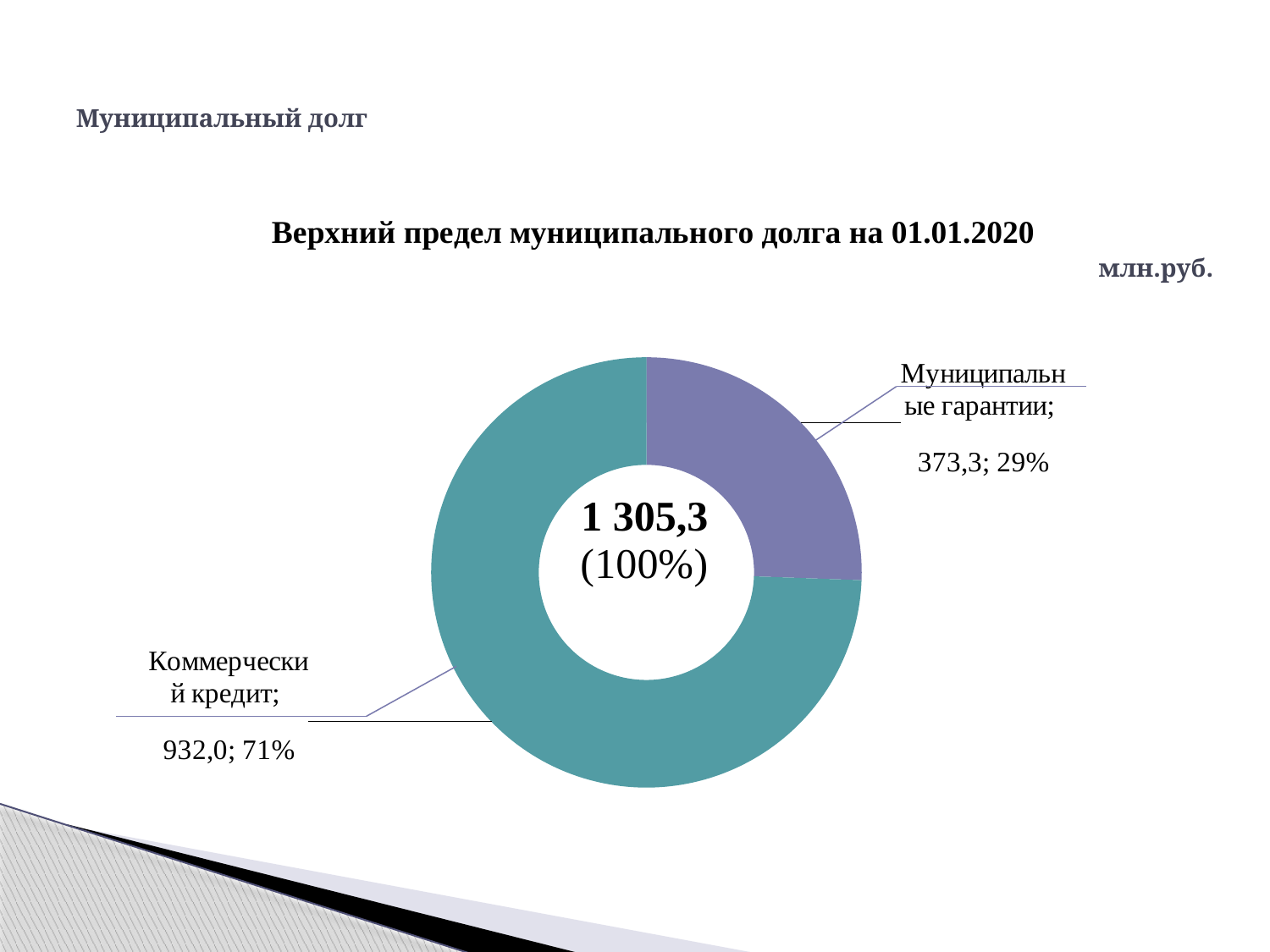
What is the value for Муниципальные гарантии? 373,3 What is the value for Коммерческий кредит? 932,0 How many categories are shown in the chart? 2 What total value is shown in the centre of the chart? 1 305,3 Which category has the smallest slice? Муниципальные гарантии What share of the chart does Коммерческий кредит represent? 71% Which category has the largest slice? Коммерческий кредит Which is larger: Коммерческий кредит or Муниципальные гарантии? Коммерческий кредит What is the title of the chart? Верхний предел муниципального долга на 01.01.2020 What kind of chart is shown on the slide? Doughnut (pie) chart What is the difference between the values for Коммерческий кредит and Муниципальные гарантии? 558,7 What share of the chart does Муниципальные гарантии represent? 29%